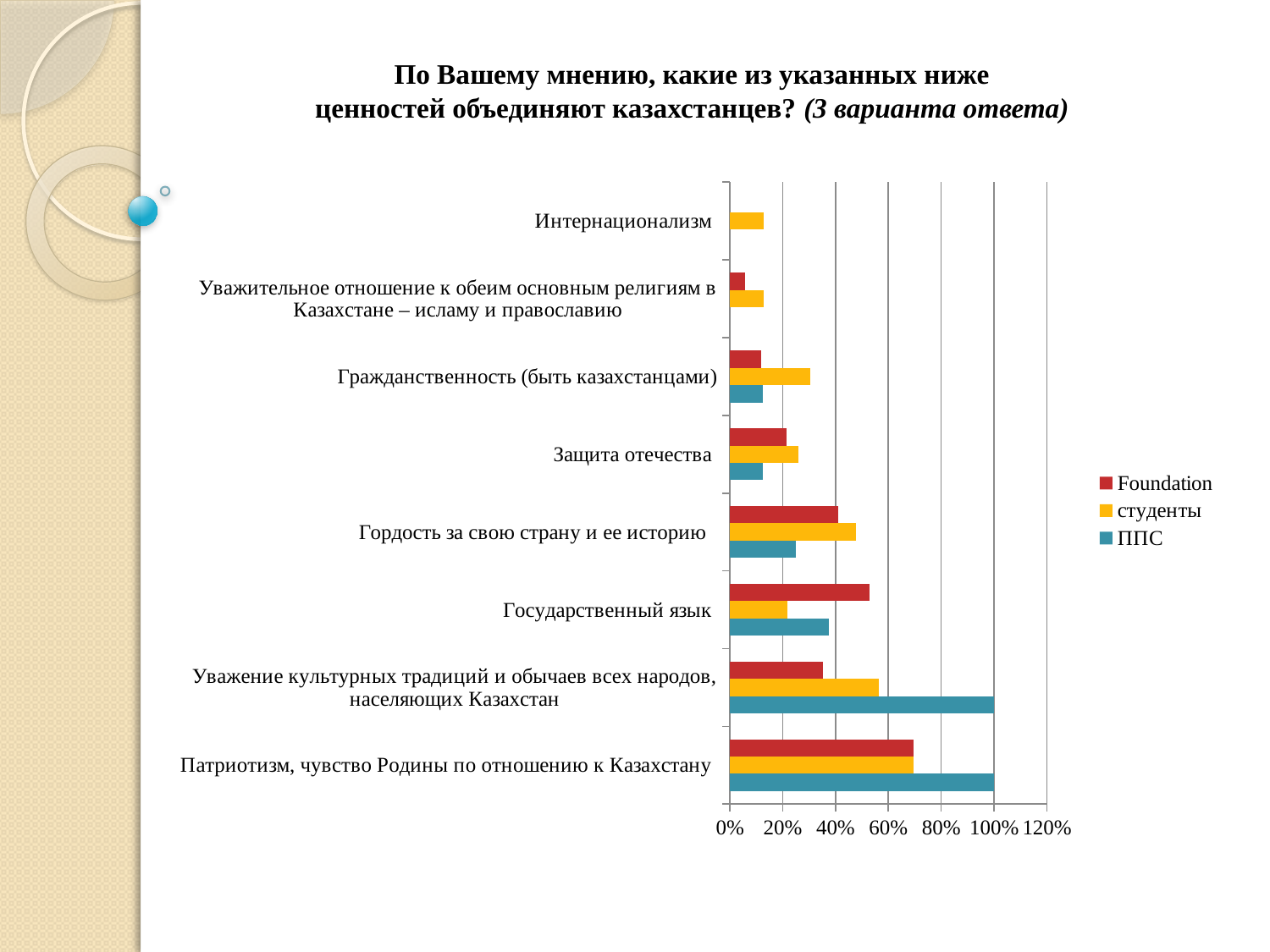
How many series does the legend list? 3 For "Гордость за свою страну и ее историю", which is larger: the Foundation value or the студенты value? студенты How many categories are plotted on the chart? 8 Is the студенты value for "Интернационализм" greater or less than 20%? less What is the ППС value for "Уважение культурных традиций и обычаев всех народов, населяющих Казахстан"? 100% What colour represents the ППС series in the chart? blue Is the Foundation value for "Государственный язык" greater or less than 40%? greater What is the ППС value for "Патриотизм, чувство Родины по отношению к Казахстану"? 100% Is the Foundation value for "Уважение культурных традиций и обычаев всех народов, населяющих Казахстан" greater or less than 40%? less Which series has the lowest value for "Гордость за свою страну и ее историю"? ППС Which series has the highest value for "Государственный язык"? Foundation What kind of chart is shown on the slide? bar chart